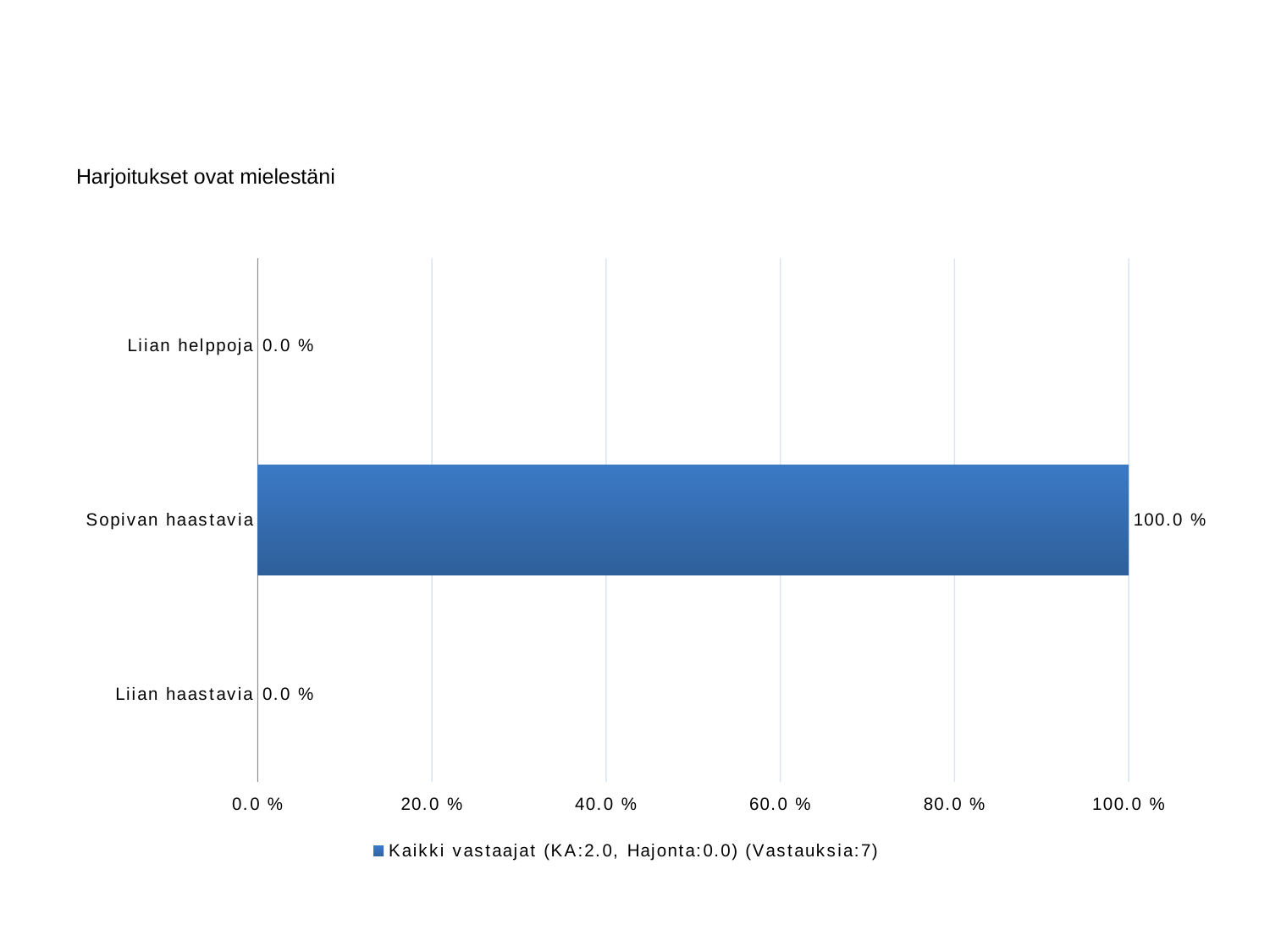
Which category has the highest value? Sopivan haastavia Which is larger, the value for Sopivan haastavia or the value for Liian haastavia? Sopivan haastavia How many responses (Vastauksia) does the legend entry report? 7 What is the value for Liian helppoja? 0.0 % How many categories are shown on the chart? 3 What is the value for Sopivan haastavia? 100.0 % How many series does the legend list? 1 What is the title of the chart? Harjoitukset ovat mielestäni What is the value for Liian haastavia? 0.0 % What kind of chart is shown on the slide? bar chart What is the difference between the values for Sopivan haastavia and Liian helppoja? 100.0 % Is the value for Sopivan haastavia greater or less than 60.0 %? greater